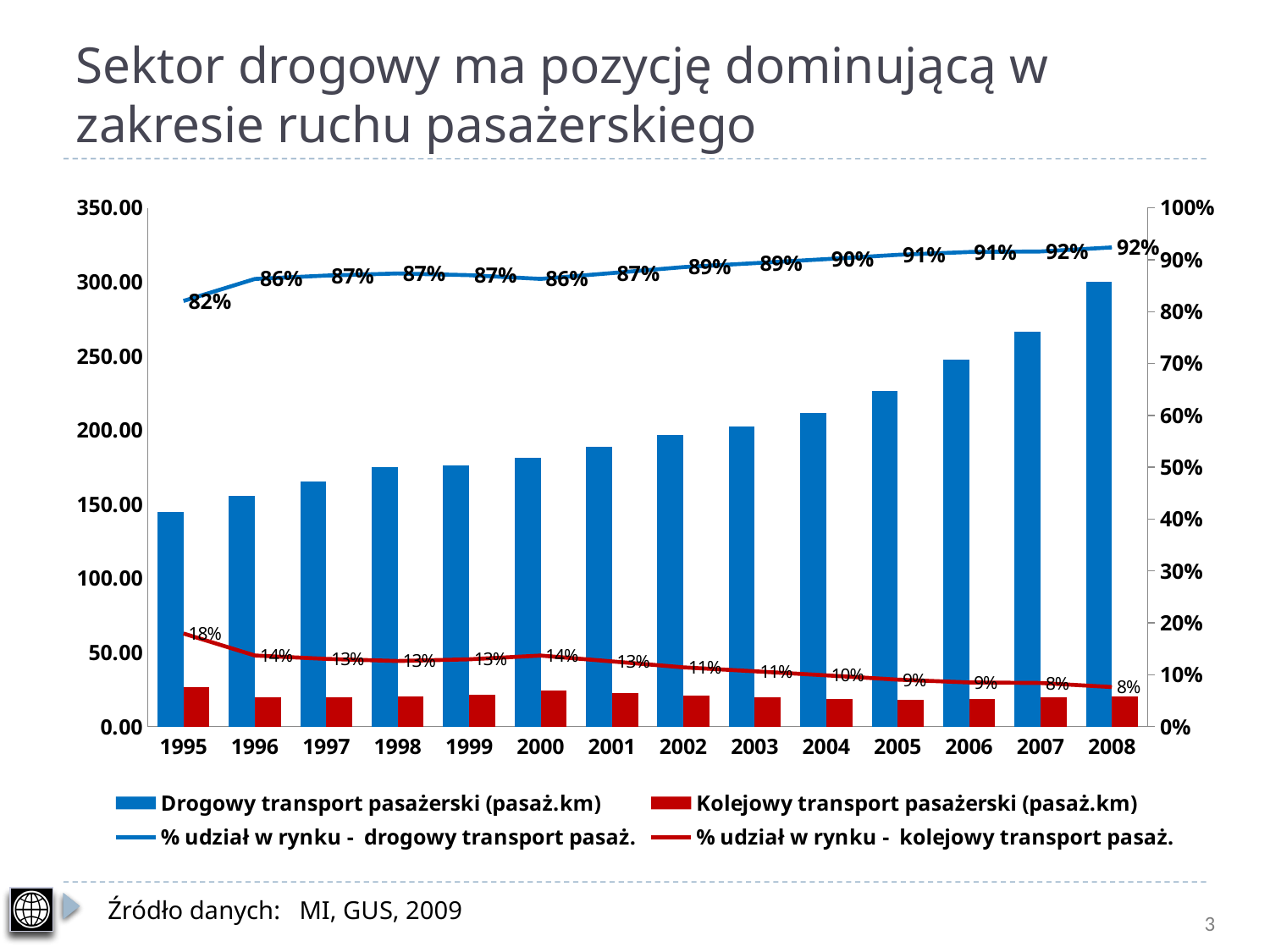
How many series does the chart legend list? 4 Which year has a higher road passenger transport market share, 2000 or 2002? 2002 What is the market share of road passenger transport (% udział w rynku - drogowy transport pasaż.) in 1995? 82% In which year is the road passenger transport market share the lowest? 1995 What is the market share of road passenger transport in 2004? 90% Is the value of the Drogowy transport pasażerski (pasaż.km) bar for 2008 greater or less than 250? greater How many years are shown on the x axis of the chart? 14 In which year is the rail passenger transport market share the highest? 1995 What is the market share of rail passenger transport (% udział w rynku - kolejowy transport pasaż.) in 2008? 8% Is the value of the Drogowy transport pasażerski (pasaż.km) bar for 1995 greater or less than 150? less By how many percentage points did the road passenger transport market share increase from 1995 to 2008? 10 percentage points Does the road passenger transport market share generally rise or fall from 1995 to 2008? rise